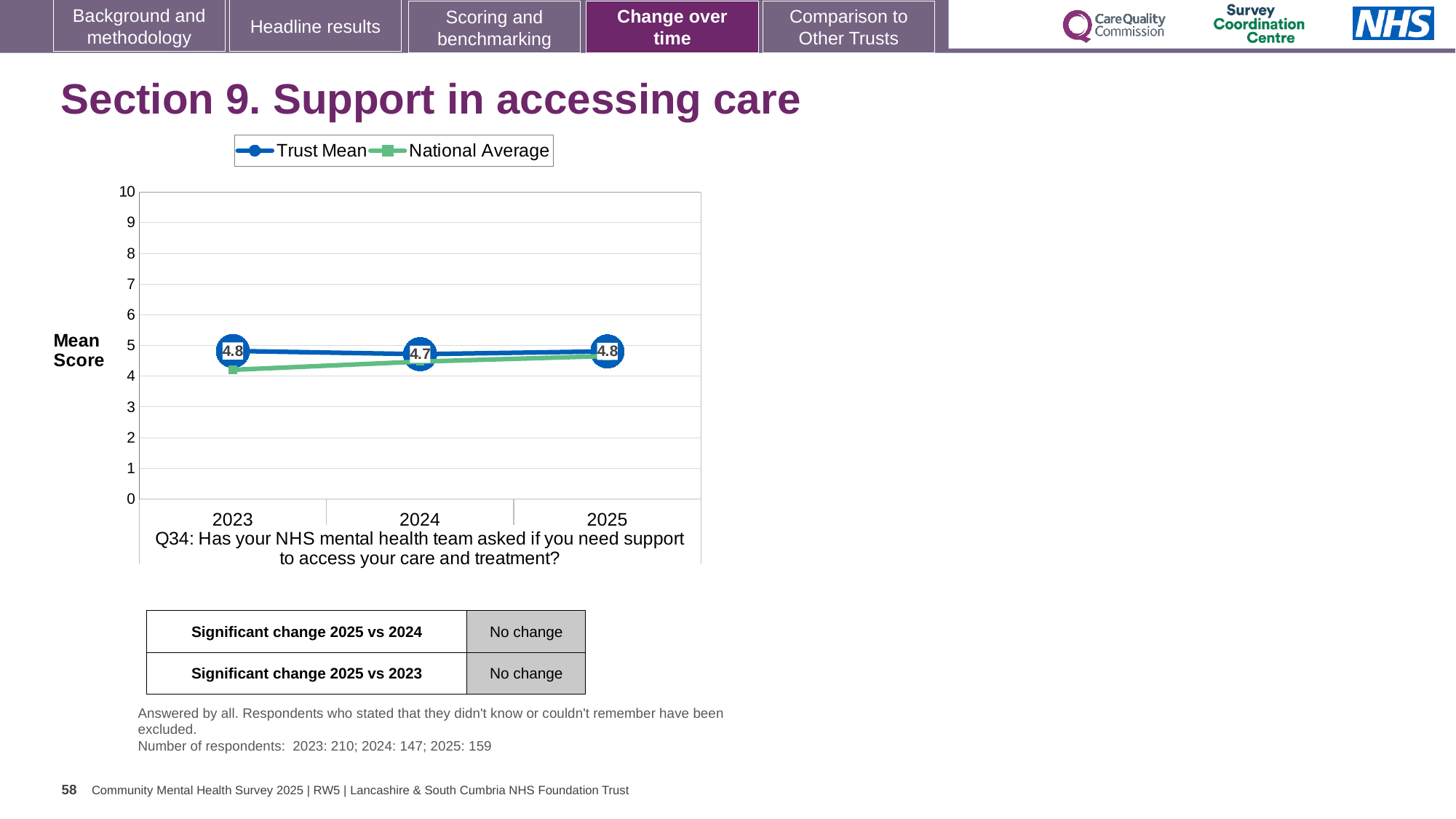
What is the label on the y axis of the chart? Mean Score Is the National Average value for 2023 greater or less than 5? less How many years are shown on the x axis of the chart? 3 Which is larger, the Trust Mean score for 2024 or for 2025? 2025 What is the Trust Mean score for 2025? 4.8 What kind of chart is shown on the slide? line chart In which year is the Trust Mean score lowest? 2024 Does the National Average line rise or fall from 2023 to 2025? rise How many series does the chart legend list? 2 What is the difference between the Trust Mean scores for 2023 and 2024? 0.1 What is the Trust Mean score for 2024? 4.7 What is the Trust Mean score for 2023? 4.8